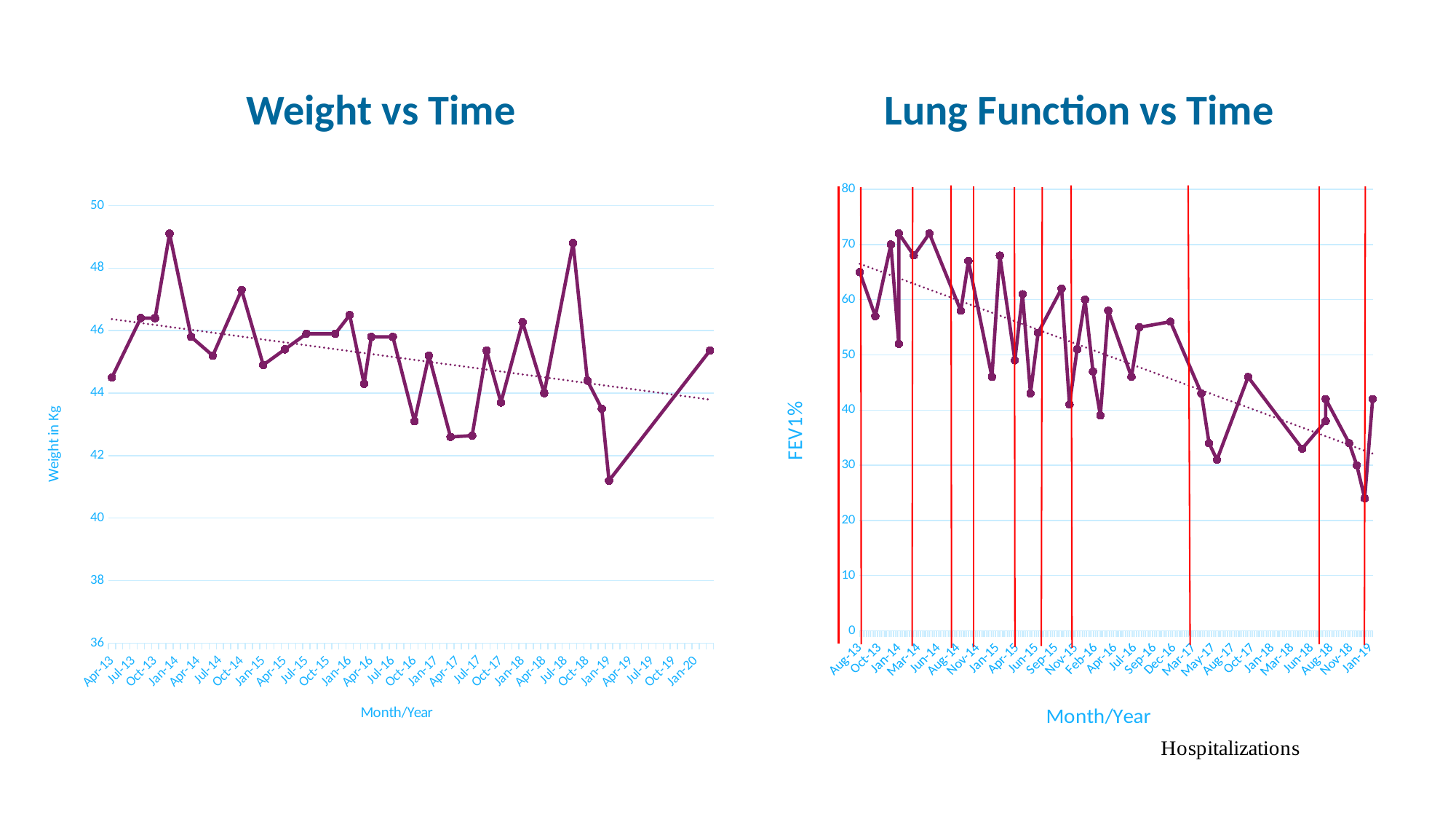
What kind of chart is the Lung Function vs Time chart? line chart In the Lung Function vs Time chart, at which month/year is FEV1% lowest? Jan-19 In the Weight vs Time chart, is the value for Jan-14 greater or less than 48? greater In the Weight vs Time chart, do the values generally rise or fall over time? fall In the Lung Function vs Time chart, is the value for Jan-19 greater or less than 30? less In the Weight vs Time chart, is the value for Jan-19 greater or less than 42? less What is the y-axis label of the Lung Function vs Time chart? FEV1% In the Weight vs Time chart, at which month/year is the weight lowest? Jan-19 What kind of chart is the Weight vs Time chart? line chart In the Lung Function vs Time chart, do the values generally rise or fall over time? fall